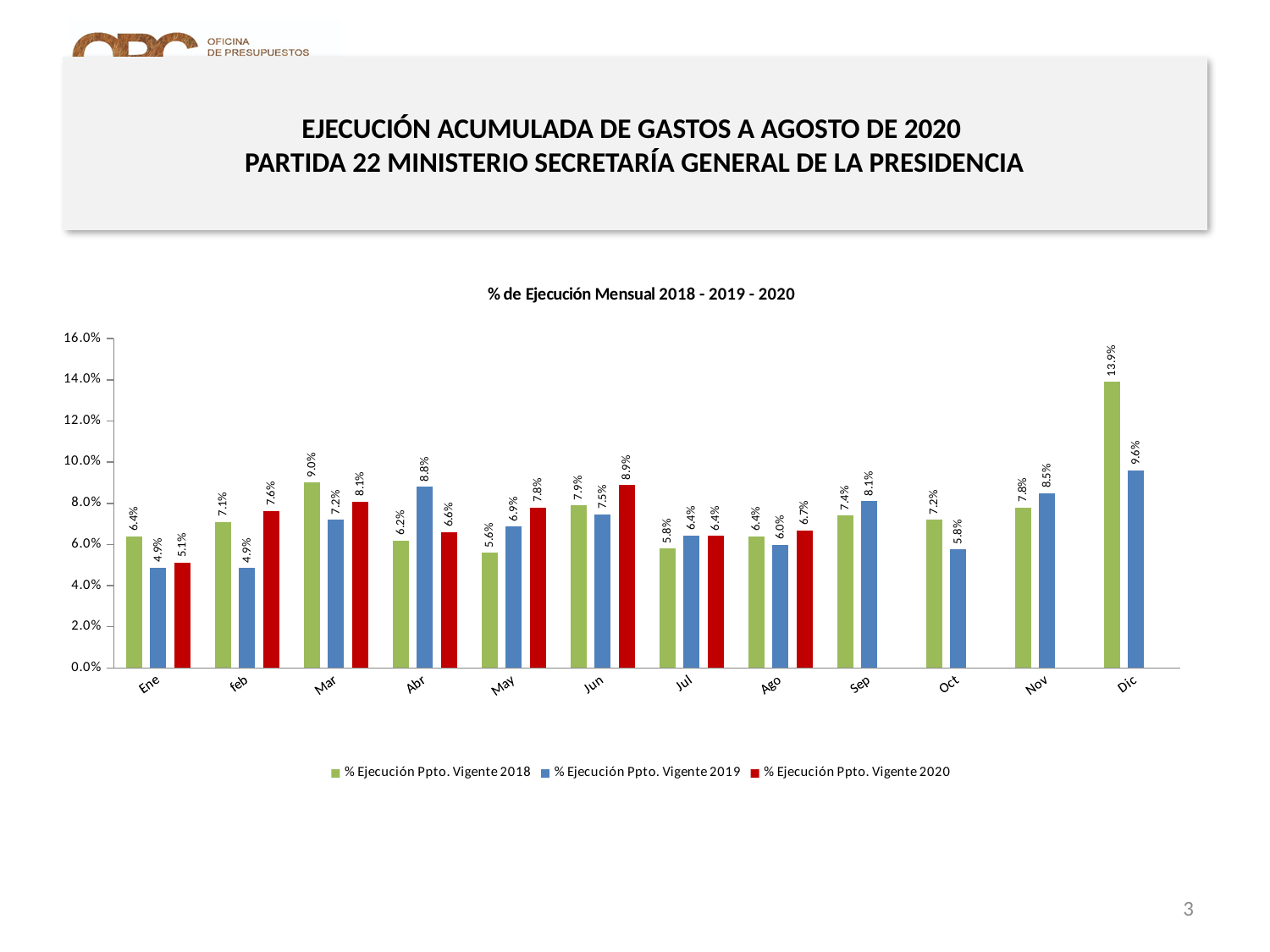
Which is larger in Mar: the 2018 value or the 2020 value? 2018 (9.0%) In which month is the % Ejecución Ppto. Vigente 2018 series lowest? May What is the value for % Ejecución Ppto. Vigente 2019 in Abr? 8.8% What kind of chart is shown? Bar chart In which month is the % Ejecución Ppto. Vigente 2018 series highest? Dic What is the value for % Ejecución Ppto. Vigente 2020 in Jun? 8.9% How many months are shown on the x axis? 12 What is the value for % Ejecución Ppto. Vigente 2018 in Dic? 13.9% What colour represents the % Ejecución Ppto. Vigente 2020 series? Red What is the difference between the 2018 and 2019 values in Dic? 4.3% What is the difference between the 2020 and 2019 values in Feb? 2.7% How many series does the legend list? 3